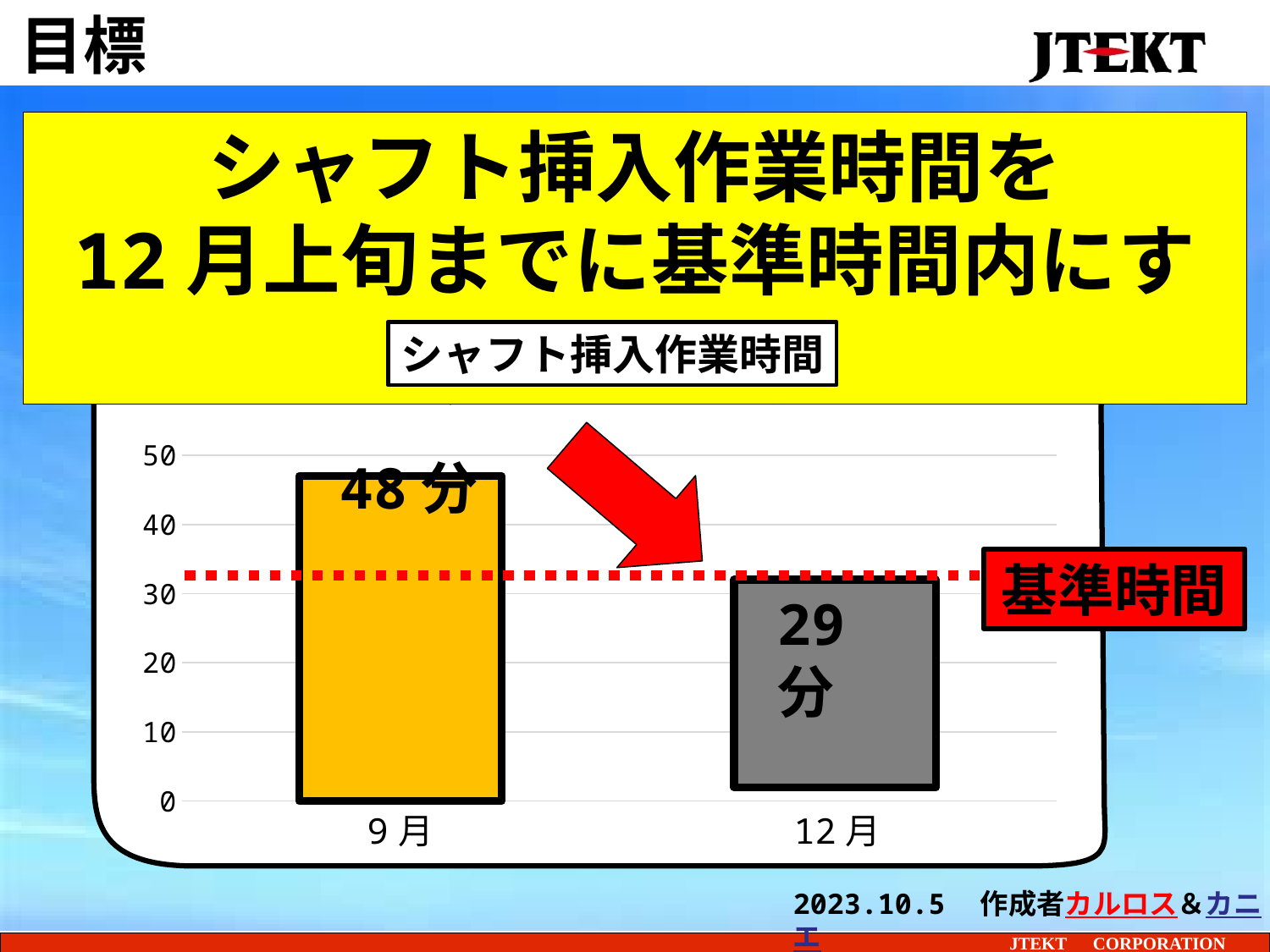
Is the value for 9月 greater or less than 40 in the シャフト挿入作業時間 chart? greater Do the values rise or fall from 9月 to 12月 in the シャフト挿入作業時間 chart? fall What is the value for 9月 in the シャフト挿入作業時間 chart? 48分 Which category has the lowest value in the シャフト挿入作業時間 chart? 12月 What is the difference between the 9月 and 12月 values in the シャフト挿入作業時間 chart? 19分 Which category has the highest value in the シャフト挿入作業時間 chart? 9月 How many categories are shown on the x axis of the シャフト挿入作業時間 chart? 2 What does the red dotted horizontal line in the シャフト挿入作業時間 chart represent? 基準時間 What is the value for 12月 in the シャフト挿入作業時間 chart? 29分 Which is larger in the シャフト挿入作業時間 chart, the value for 9月 or for 12月? 9月 What kind of chart is the シャフト挿入作業時間 chart? bar chart